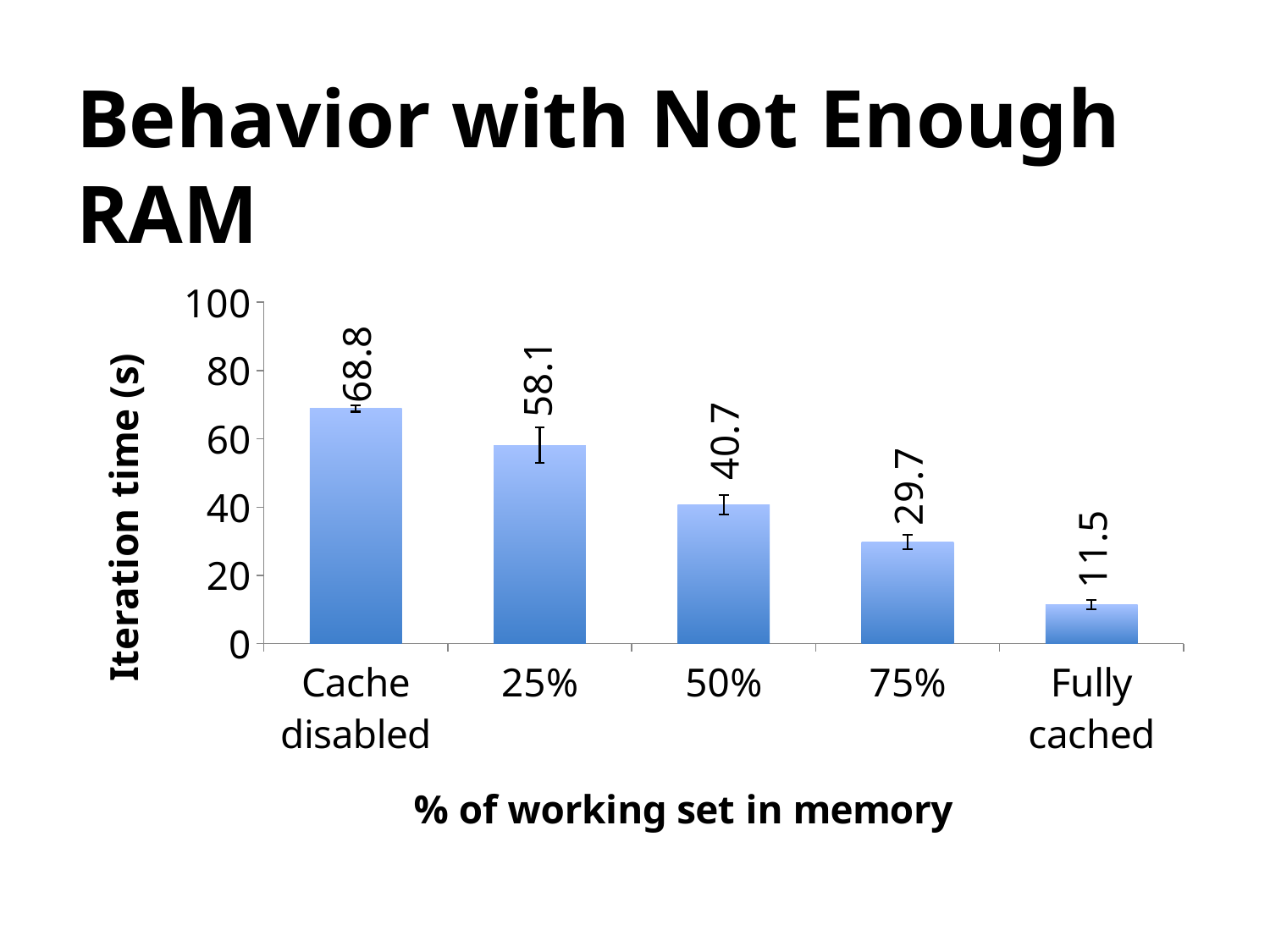
Do the iteration times rise or fall moving from left to right along the x axis? Fall What is the iteration time for the 50% category? 40.7 Which category has the lowest iteration time? Fully cached What is the difference in iteration time between Cache disabled and Fully cached? 57.3 What kind of chart is shown on the slide? Bar chart What is the iteration time for the Fully cached category? 11.5 What is the iteration time when the cache is disabled? 68.8 Which has a larger iteration time, 50% or 75%? 50% Which category has the highest iteration time? Cache disabled How many categories are shown on the x axis? 5 What is the difference in iteration time between the 25% and 75% categories? 28.4 Is the iteration time for 25% greater or less than 40? greater